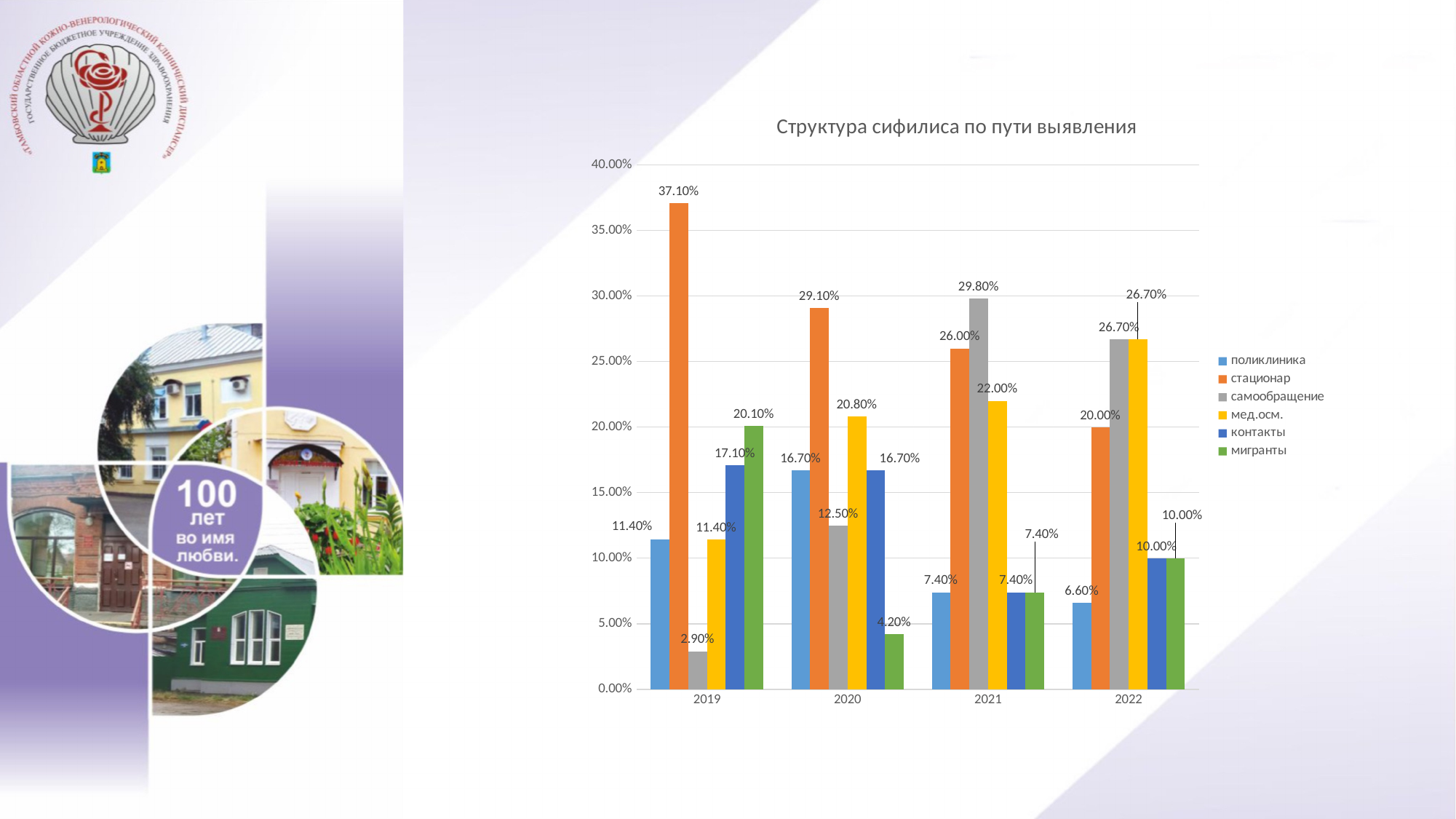
Does the value for стационар rise or fall from 2019 to 2022? fall In which year is the value for стационар the highest? 2019 How many years are shown on the x axis? 4 In which year is the value for самообращение the lowest? 2019 Which year has the larger value for мед.осм., 2020 or 2021? 2021 What is the difference between the стационар values in 2019 and 2022? 17.10% Is the value for мигранты in 2019 greater or less than 15.00%? greater How many series does the legend list? 6 What kind of chart is shown on the slide? bar chart What is the value for стационар in 2019? 37.10% What is the value for мигранты in 2020? 4.20% What is the value for самообращение in 2021? 29.80%